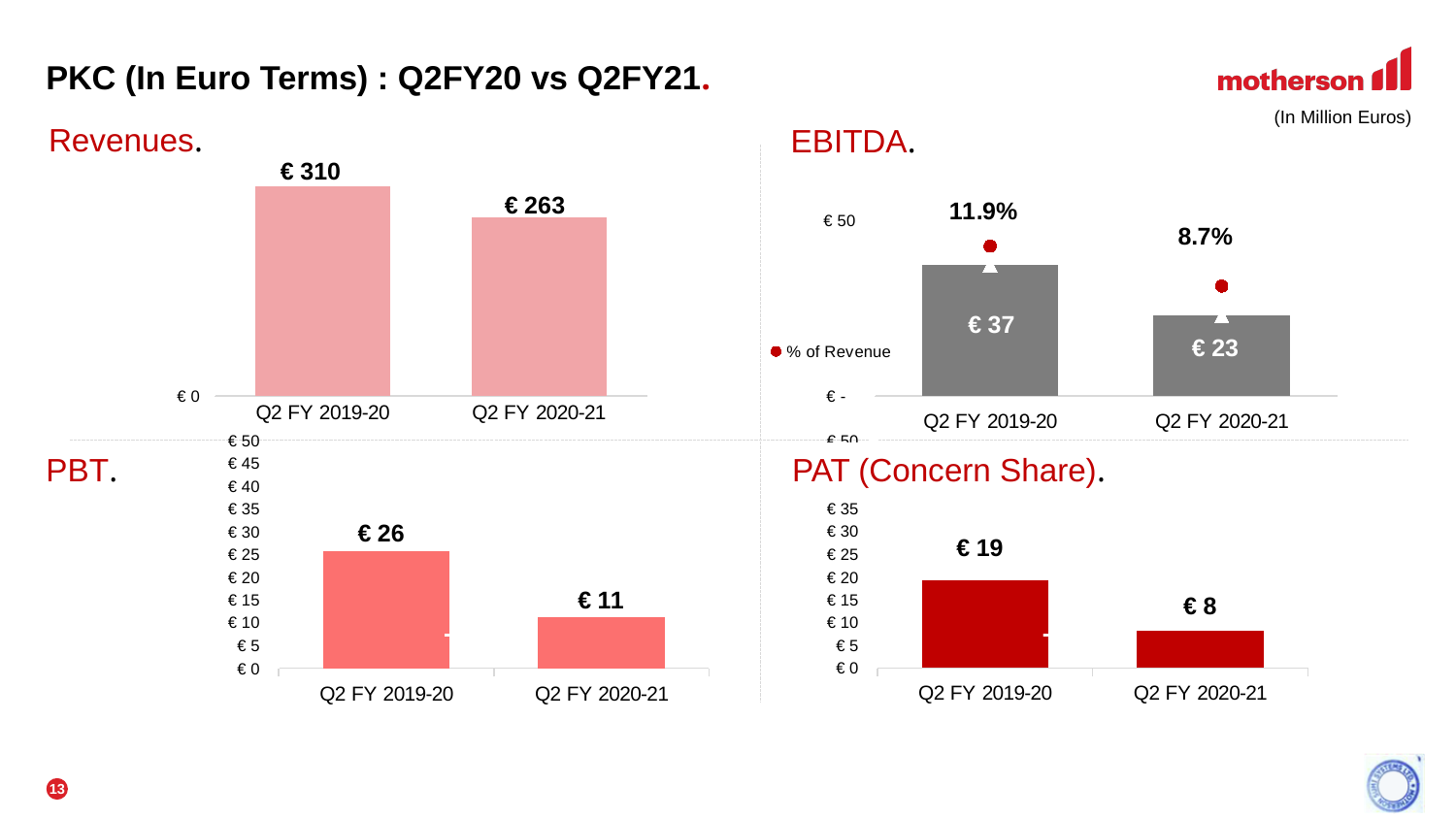
In the PBT chart, what is the difference between Q2 FY 2019-20 and Q2 FY 2020-21? € 15 In the Revenues chart, what is the value for Q2 FY 2020-21? € 263 In the PAT (Concern Share) chart, what is the value for Q2 FY 2020-21? € 8 In the PAT (Concern Share) chart, which quarter has the lower value? Q2 FY 2020-21 In the PBT chart, what is the value for Q2 FY 2019-20? € 26 In the Revenues chart, what is the value for Q2 FY 2019-20? € 310 In the EBITDA chart, what is the EBITDA value for Q2 FY 2020-21? € 23 In the EBITDA chart, what is the % of Revenue for Q2 FY 2019-20? 11.9% How many categories are shown on the x axis of the PBT chart? 2 In the EBITDA chart, which quarter has the higher EBITDA? Q2 FY 2019-20 What kind of chart is the Revenues chart? Bar chart In the Revenues chart, what is the difference between Q2 FY 2019-20 and Q2 FY 2020-21? € 47